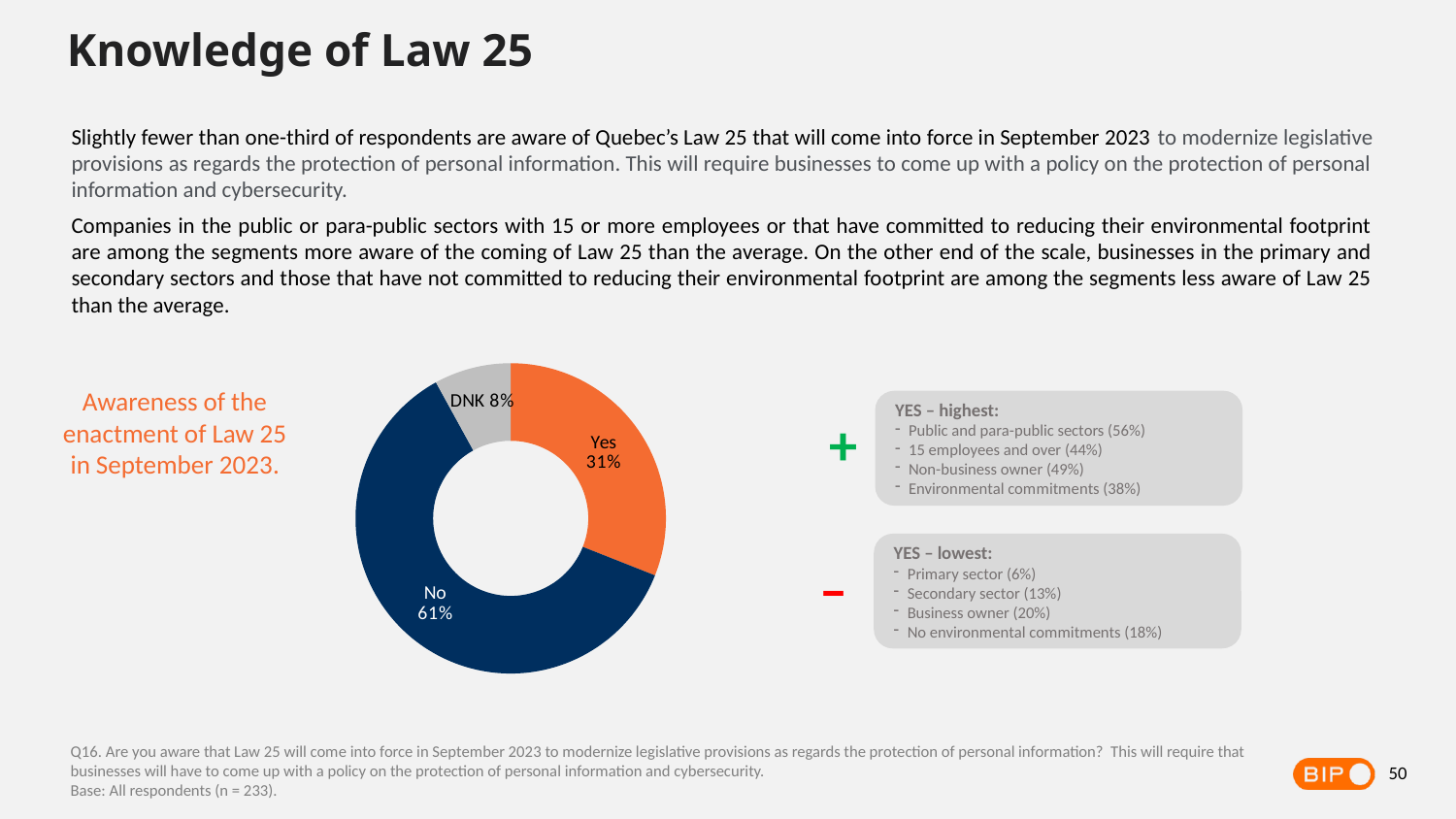
Which response has the smallest share in the awareness of Law 25 chart? DNK What colour is the Yes slice in the awareness of Law 25 chart? Orange What percentage of respondents answered DNK in the awareness of Law 25 chart? 8% How many categories are shown in the awareness of Law 25 chart? 3 Which response has the largest share in the awareness of Law 25 chart? No Which is larger in the awareness of Law 25 chart, the Yes share or the DNK share? Yes What percentage of respondents answered Yes in the awareness of Law 25 chart? 31% What is the combined share of Yes and No in the awareness of Law 25 chart? 92% What kind of chart is used to show awareness of the enactment of Law 25? Pie chart (donut) What colour is the No slice in the awareness of Law 25 chart? Dark blue What percentage of respondents answered No in the awareness of Law 25 chart? 61% What is the difference in percentage points between the No and Yes shares in the awareness of Law 25 chart? 30